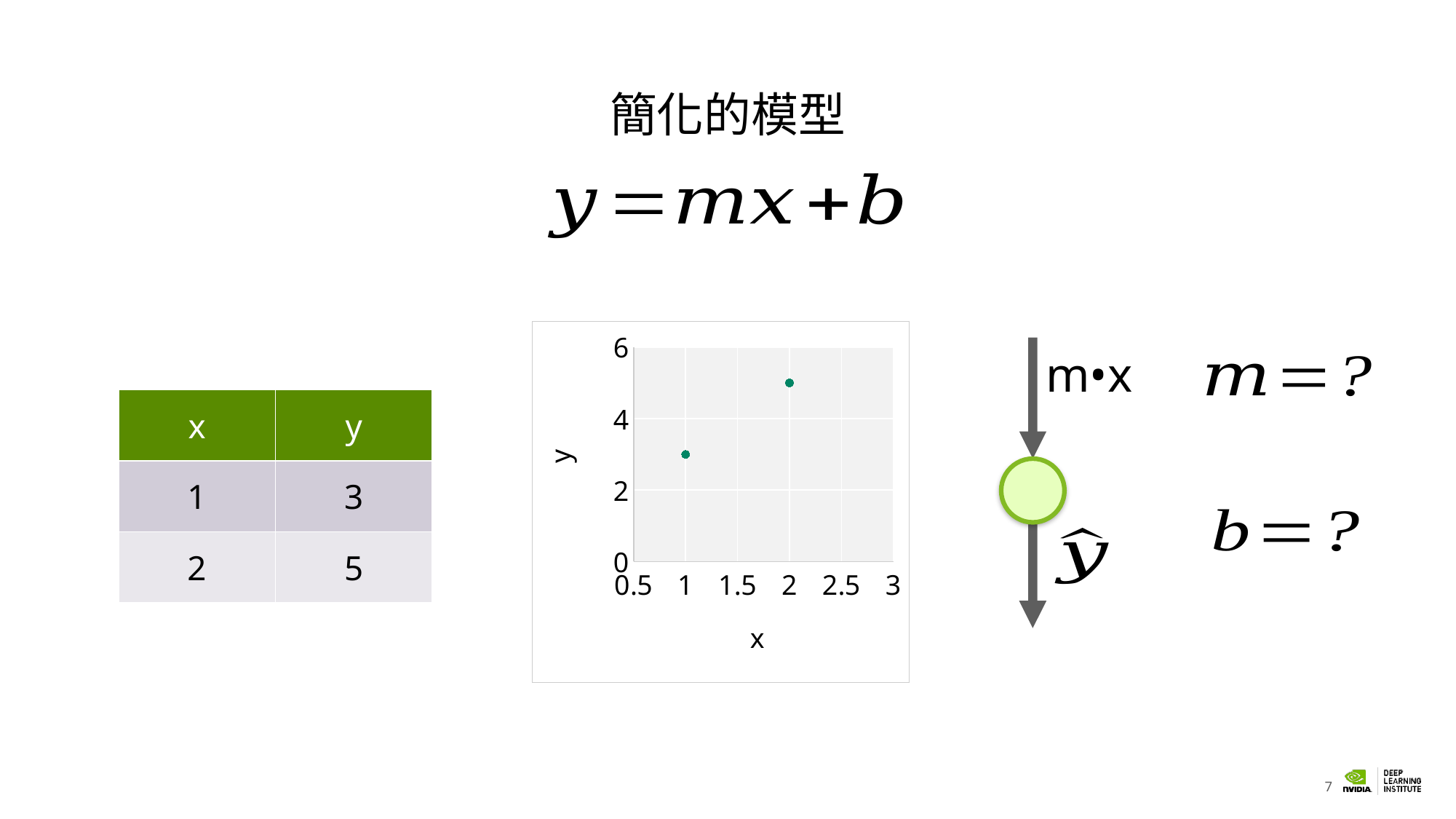
At which x value does the chart show its highest y value? 2 Is the y value of the point at x = 1 greater or less than 4? less Is the y value of the point at x = 2 greater or less than 4? greater What is the highest tick value shown on the y axis of the chart? 6 How many data points are plotted on the chart? 2 Is the y value of the point at x = 2 greater or less than 6? less Which point has the higher y value, the one at x = 1 or the one at x = 2? x = 2 Do the plotted y values rise or fall as x increases? rise What is the label on the vertical axis of the chart? y At which x value does the chart show its lowest y value? 1 What kind of chart is shown on the slide? scatter chart